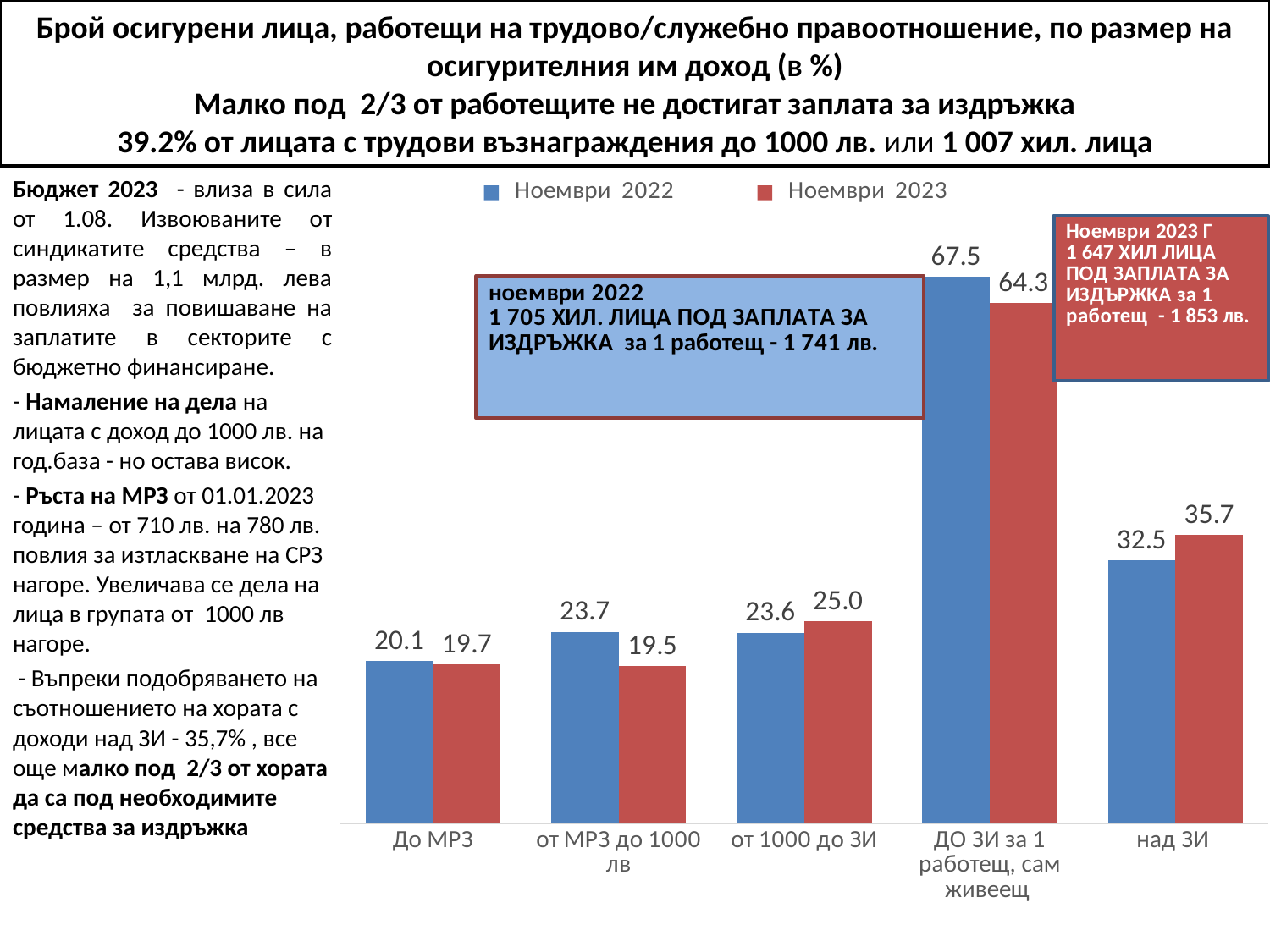
What is the value for "До МРЗ" in the Ноември 2022 series? 20.1 How many series does the chart legend list? 2 What type of chart is shown on the slide? bar chart What is the value for "над ЗИ" in the Ноември 2023 series? 35.7 Which category has the highest value in the Ноември 2022 series? ДО ЗИ за 1 работещ, сам живеещ Which category has the lowest value in the Ноември 2023 series? от МРЗ до 1000 лв What is the difference between the Ноември 2022 and Ноември 2023 values for "ДО ЗИ за 1 работещ, сам живеещ"? 3.2 How many categories are shown on the x axis of the chart? 5 For "над ЗИ", is the Ноември 2022 value larger or smaller than the Ноември 2023 value? smaller For "от 1000 до ЗИ", which series has the larger value, Ноември 2022 or Ноември 2023? Ноември 2023 Which colour represents the Ноември 2023 series in the chart? red What is the value for "от МРЗ до 1000 лв" in the Ноември 2023 series? 19.5